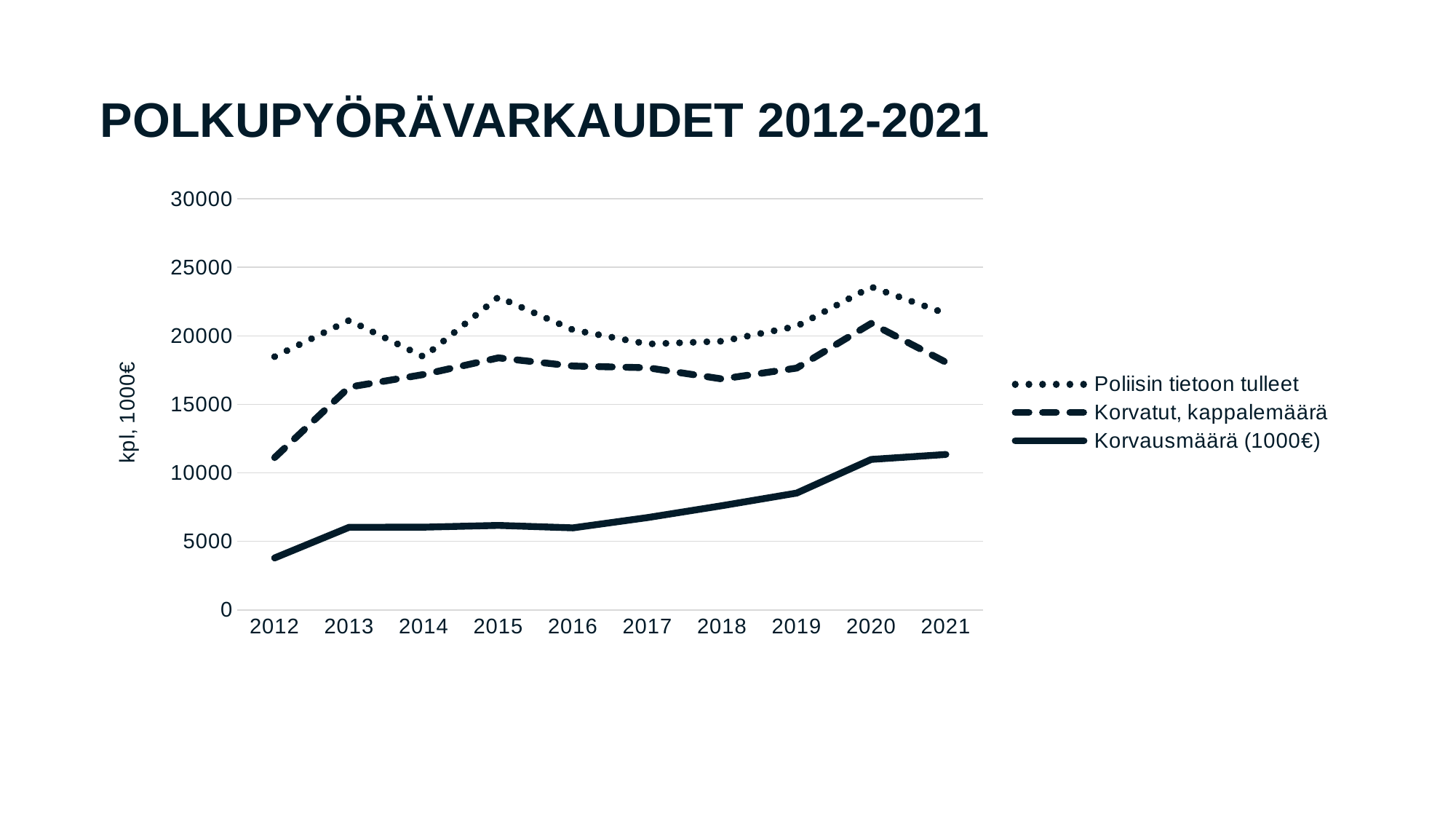
How many years are plotted along the x axis? 10 In which year is the value for Korvatut, kappalemäärä highest? 2020 In which year is the value for Korvatut, kappalemäärä lowest? 2012 How many series does the legend list? 3 What kind of chart is shown on the slide? Line chart Does the value for Korvausmäärä (1000€) rise or fall from 2016 to 2021? rise In which year is the value for Poliisin tietoon tulleet highest? 2020 In which year is the value for Korvausmäärä (1000€) lowest? 2012 Is the value for Korvatut, kappalemäärä in 2012 greater or less than 15000? less In 2013, which is larger: Poliisin tietoon tulleet or Korvatut, kappalemäärä? Poliisin tietoon tulleet Is the value for Korvausmäärä (1000€) in 2020 greater or less than 10000? greater Is the value for Poliisin tietoon tulleet in 2015 greater or less than 20000? greater